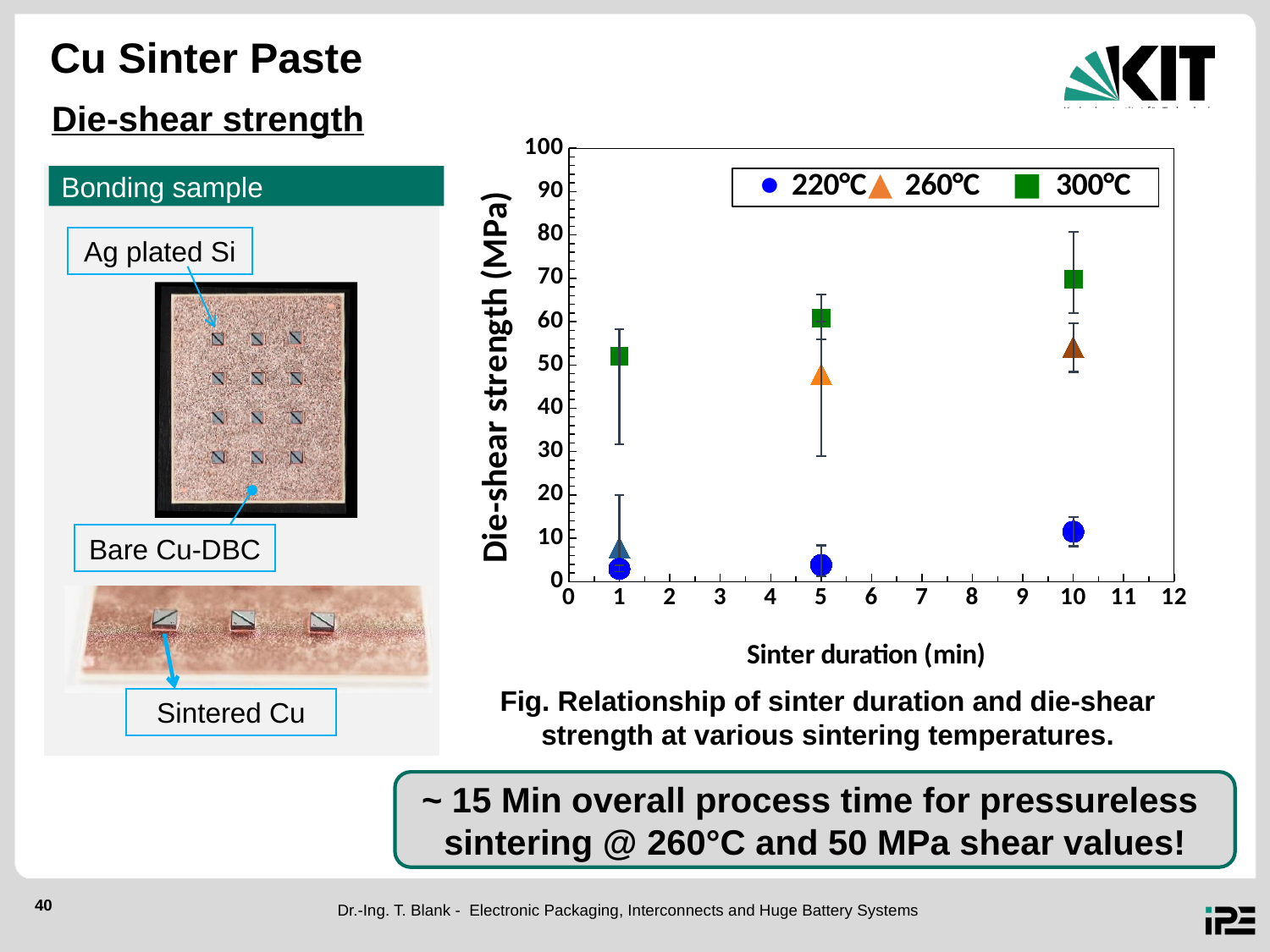
Is the die-shear strength for 260°C at 5 min greater or less than 40 MPa? greater What is the label of the y axis of the chart? Die-shear strength (MPa) What marker shape represents the 260°C series in the legend? triangle Is the die-shear strength for 220°C at 10 min greater or less than 20 MPa? less What kind of chart is used to show die-shear strength versus sinter duration? scatter chart Is the die-shear strength for 300°C at 10 min greater or less than 60 MPa? greater Which sintering temperature series has the highest die-shear strength at 10 min? 300°C At how many sinter durations are data points plotted for each series? 3 Which is larger at 1 min: the die-shear strength for 300°C or for 260°C? 300°C Does the die-shear strength for the 300°C series rise or fall as sinter duration increases? rise Which sintering temperature series has the lowest die-shear strength at 5 min? 220°C How many series does the legend list in the die-shear strength chart? 3